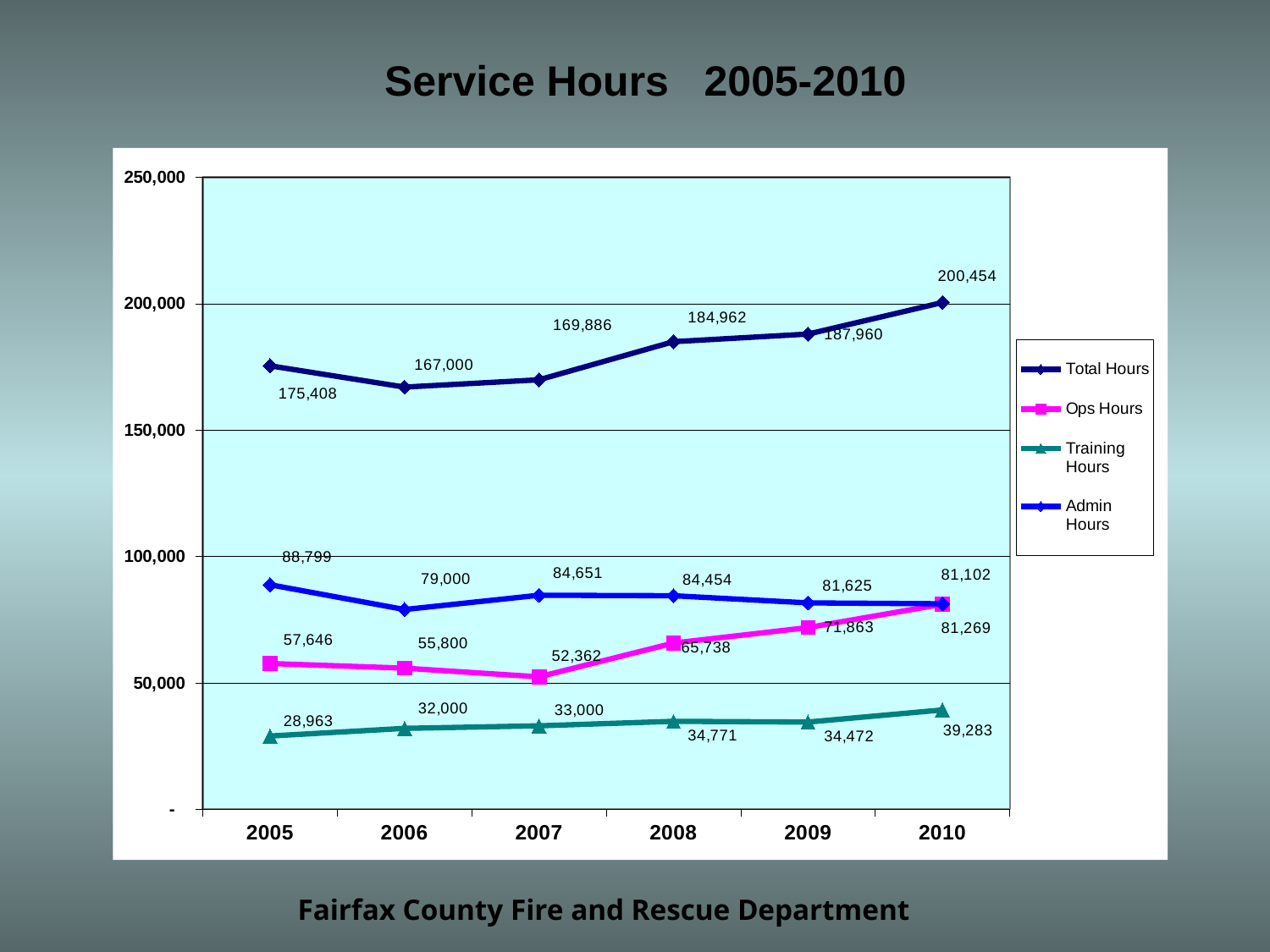
How many series does the legend list? 4 How many years are plotted along the x axis? 6 Is the value for Total Hours in 2006 greater or less than 150,000? greater What is the value of Training Hours in 2005? 28,963 In which year are Ops Hours lowest? 2007 What kind of chart is shown on the slide? line chart What is the title of the chart? Service Hours 2005-2010 What is the value of Admin Hours in 2007? 84,651 What is the difference between Total Hours in 2010 and Total Hours in 2005? 25,046 In which year are Total Hours highest? 2010 What is the value of Total Hours in 2010? 200,454 In 2005, which is larger: Admin Hours or Ops Hours? Admin Hours